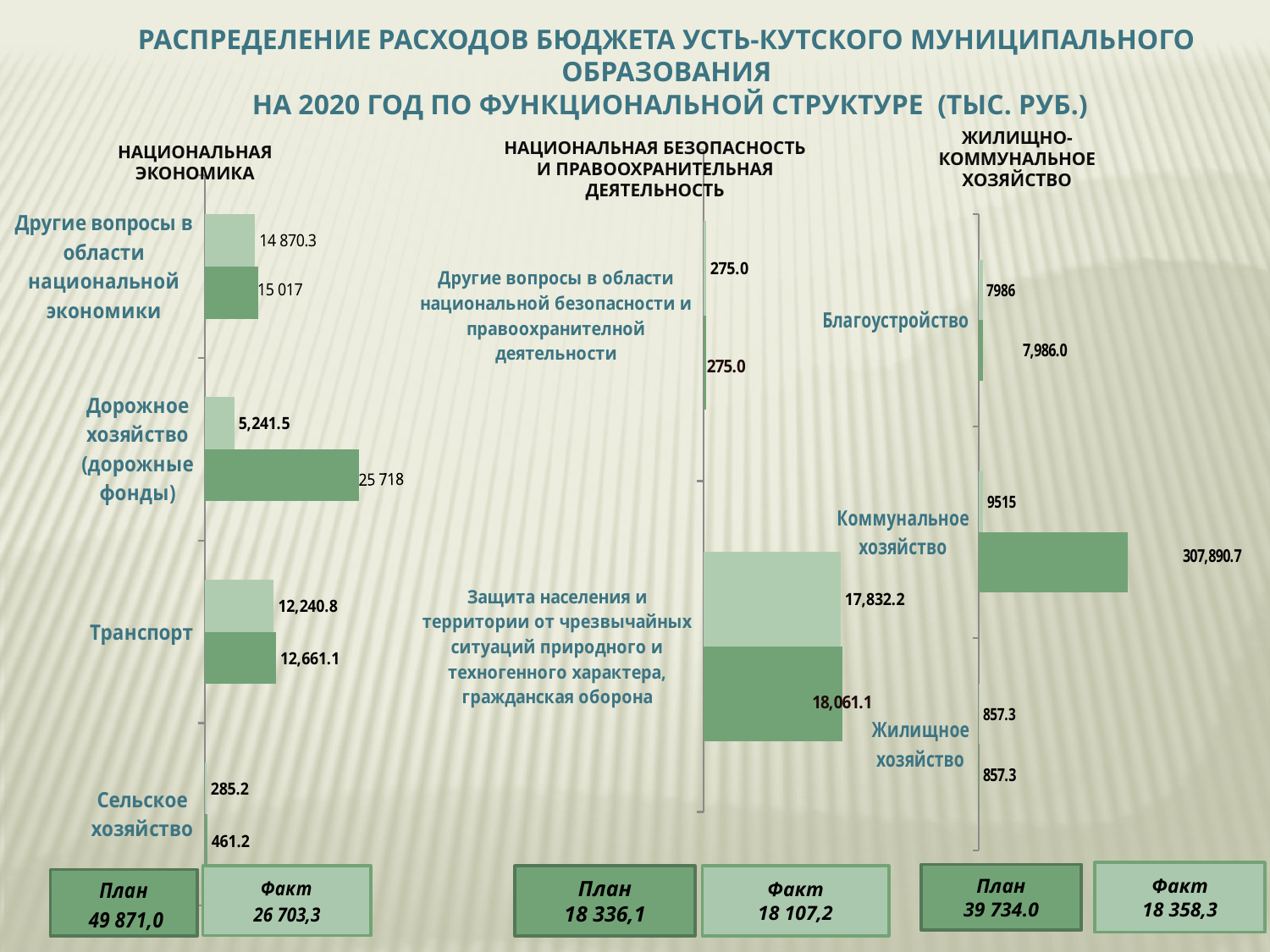
How many categories are shown in the 'Национальная экономика' chart? 4 In the 'Национальная экономика' chart, what value is labelled on the dark green bar for 'Дорожное хозяйство (дорожные фонды)'? 25 718 In the 'Жилищно-коммунальное хозяйство' chart, what value is labelled on the dark green bar for 'Коммунальное хозяйство'? 307,890.7 In the 'Национальная экономика' chart, what value is labelled on the light green bar for 'Транспорт'? 12,240.8 How many categories are shown in the 'Жилищно-коммунальное хозяйство' chart? 3 In the 'Национальная безопасность и правоохранительная деятельность' chart, which bar for 'Защита населения...' is larger: the dark green one (18,061.1) or the light green one (17,832.2)? the dark green one (18,061.1) In the 'Национальная безопасность и правоохранительная деятельность' chart, what value is labelled on the light green bar for 'Защита населения и территории от чрезвычайных ситуаций природного и техногенного характера, гражданская оборона'? 17,832.2 How many separate charts are shown on the slide? 3 In the 'Национальная экономика' chart, which category has the smallest light green bar? Сельское хозяйство In the 'Национальная экономика' chart, what is the difference between the dark green bar (12,661.1) and the light green bar (12,240.8) for 'Транспорт'? 420.3 What type of chart is used for 'Национальная экономика'? bar chart In the 'Национальная экономика' chart, which category has the longest dark green bar? Дорожное хозяйство (дорожные фонды)